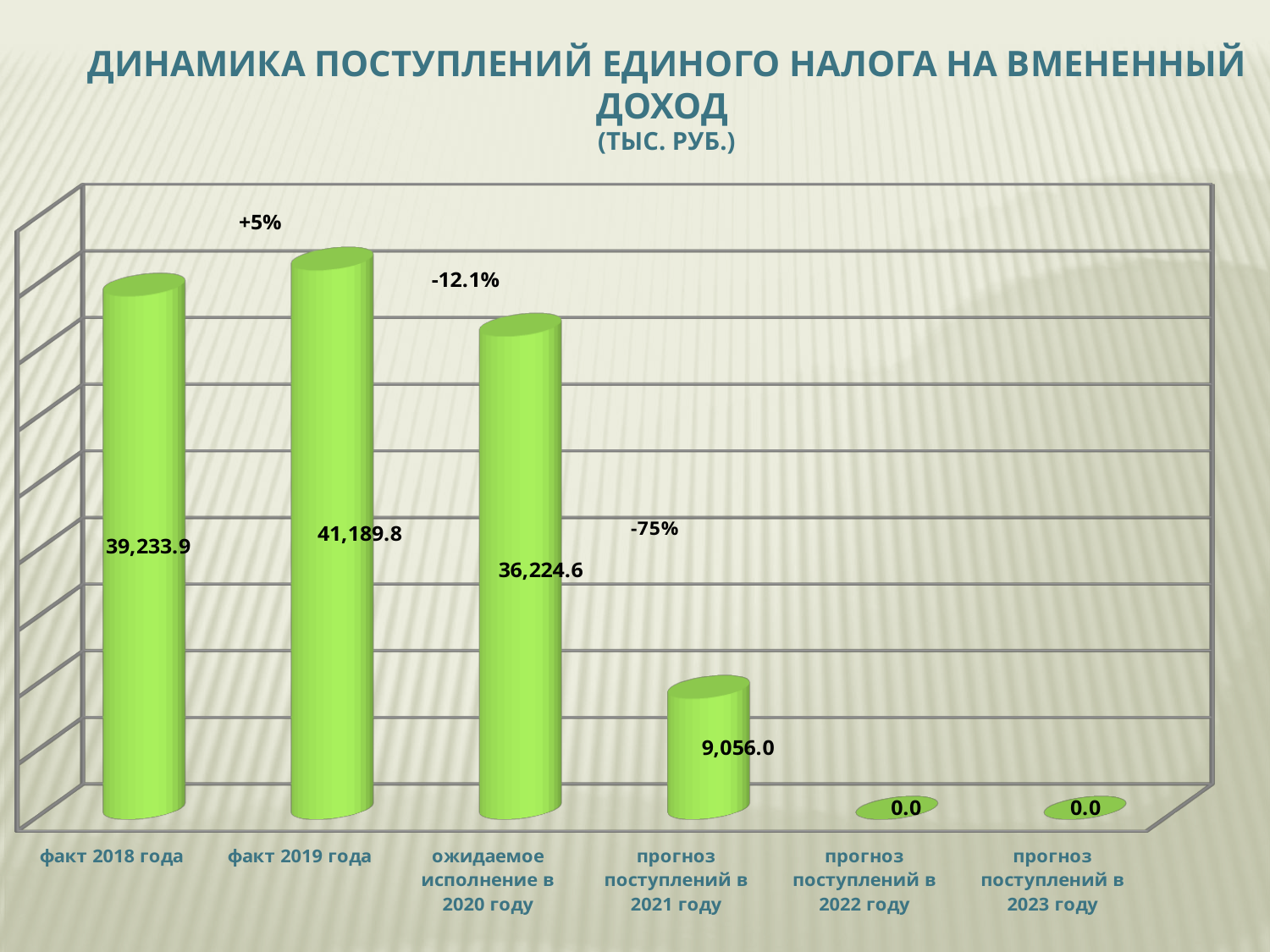
How many categories are shown on the x axis? 6 Which is larger, the value for факт 2018 года or the value for ожидаемое исполнение в 2020 году? факт 2018 года What is the difference between the values for ожидаемое исполнение в 2020 году and прогноз поступлений в 2021 году? 27,168.6 What is the value for прогноз поступлений в 2023 году? 0.0 What percentage change is annotated above the bar for ожидаемое исполнение в 2020 году? -12.1% What is the value for факт 2019 года? 41,189.8 What is the value for факт 2018 года? 39,233.9 What is the value for прогноз поступлений в 2021 году? 9,056.0 Which category has the highest value? факт 2019 года What kind of chart is shown on the slide? bar chart What is the difference between the values for факт 2019 года and факт 2018 года? 1,955.9 What is the value for ожидаемое исполнение в 2020 году? 36,224.6